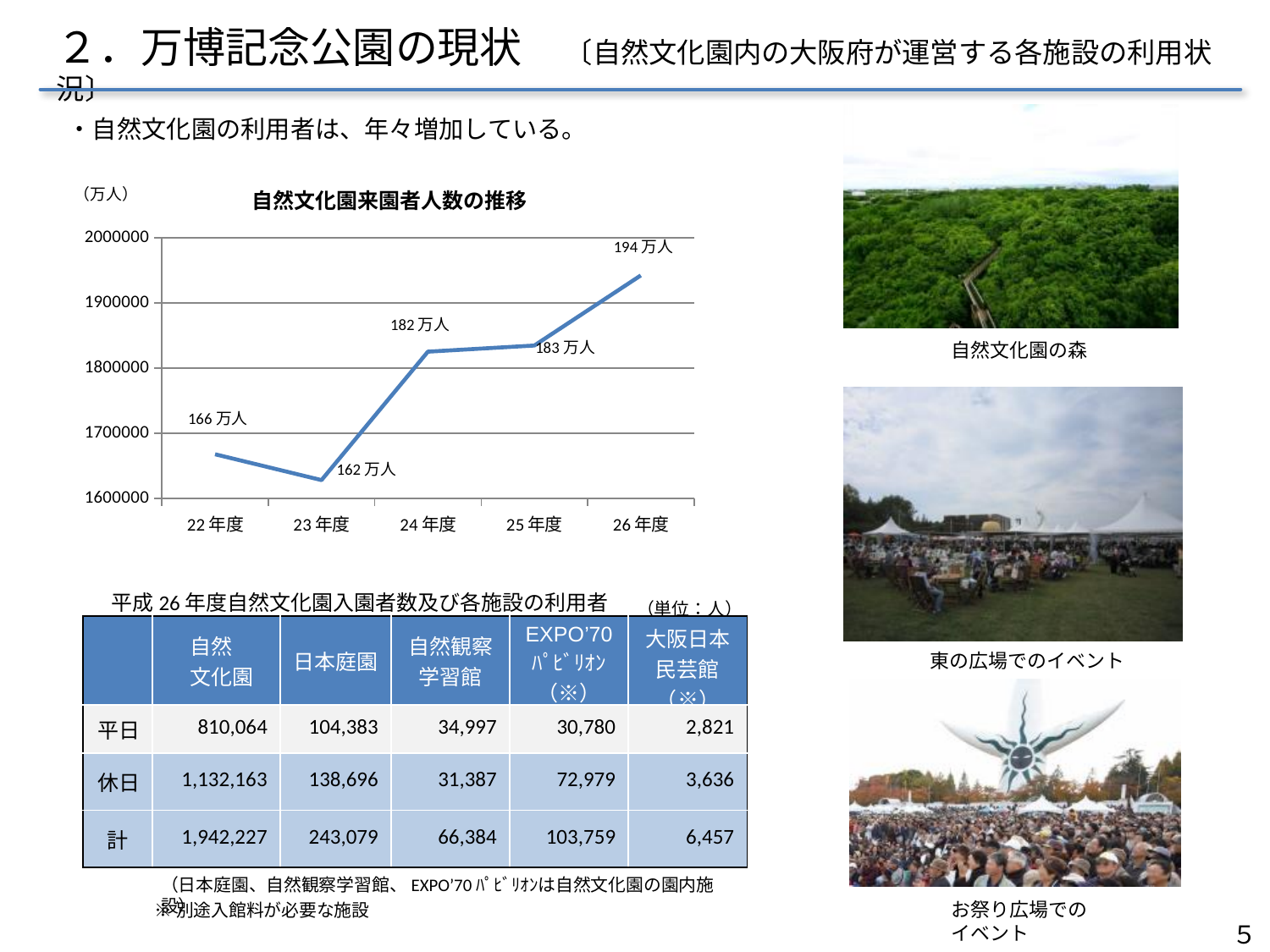
In the chart 自然文化園来園者人数の推移, what is the value for 22年度? 166 万人 In the chart 自然文化園来園者人数の推移, which year has the lowest value? 23年度 In the chart 自然文化園来園者人数の推移, is the value for 22年度 greater or less than 1700000? less In the chart 自然文化園来園者人数の推移, which is larger, the value for 23年度 or the value for 26年度? 26年度 In the chart 自然文化園来園者人数の推移, do the values rise or fall from 23年度 to 26年度? rise In the chart 自然文化園来園者人数の推移, which year has the highest value? 26年度 In the chart 自然文化園来園者人数の推移, what is the difference between the values for 26年度 and 22年度? 28 万人 How many years are plotted in the chart 自然文化園来園者人数の推移? 5 In the chart 自然文化園来園者人数の推移, what is the difference between the values for 24年度 and 23年度? 20 万人 In the chart 自然文化園来園者人数の推移, what is the value for 23年度? 162 万人 In the chart 自然文化園来園者人数の推移, what is the value for 26年度? 194 万人 What kind of chart is 自然文化園来園者人数の推移? line chart